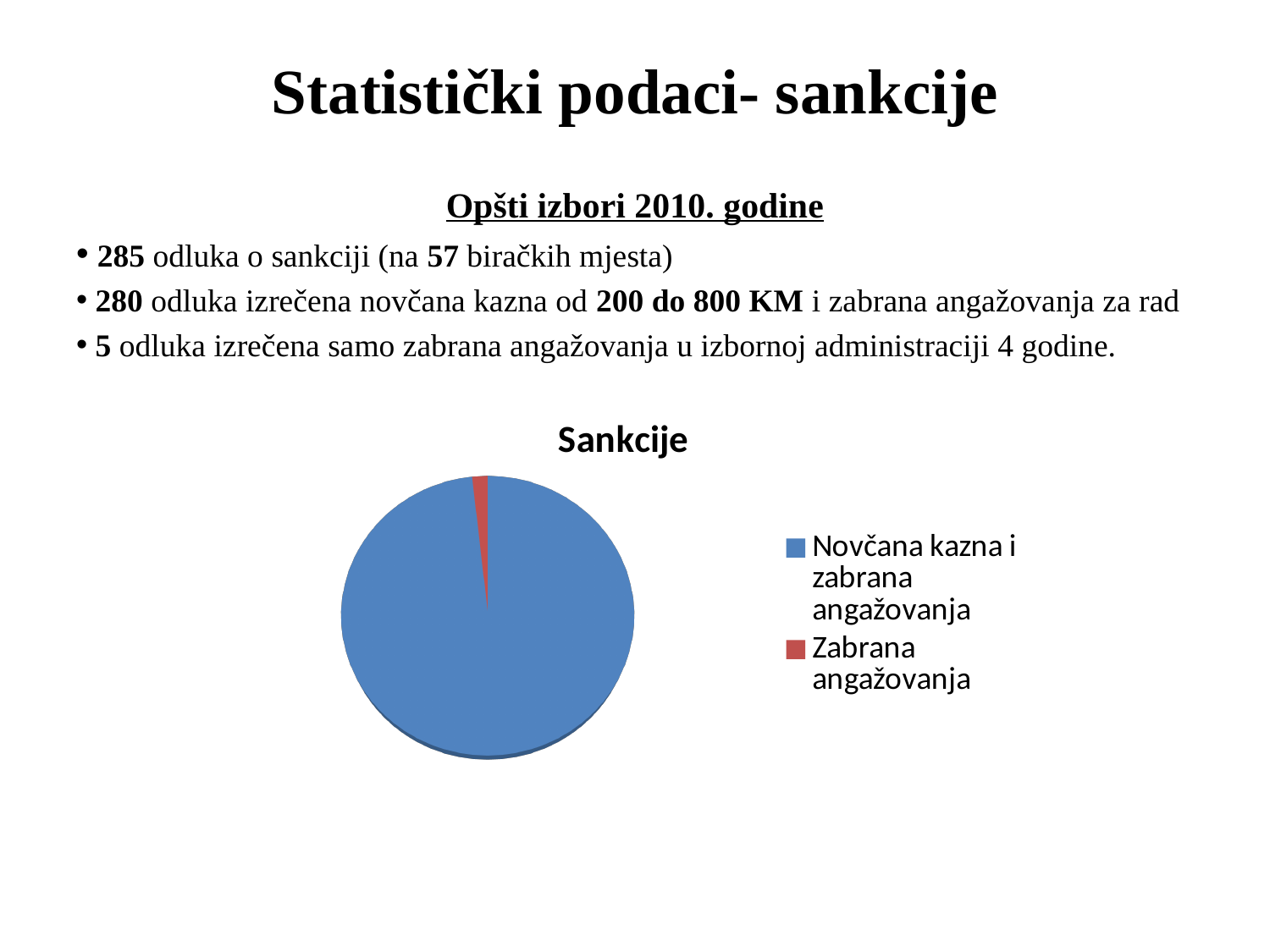
What colour is the "Zabrana angažovanja" slice in the "Sankcije" pie chart? red How many slices does the "Sankcije" pie chart have? 2 What is the title of the chart on the slide? Sankcije How many entries does the legend of the "Sankcije" chart list? 2 In the "Sankcije" pie chart, which slice is larger: "Novčana kazna i zabrana angažovanja" or "Zabrana angažovanja"? Novčana kazna i zabrana angažovanja Which category takes the smallest share of the "Sankcije" pie chart? Zabrana angažovanja What kind of chart is shown under the title "Sankcije"? pie chart Which category takes the largest share of the "Sankcije" pie chart? Novčana kazna i zabrana angažovanja